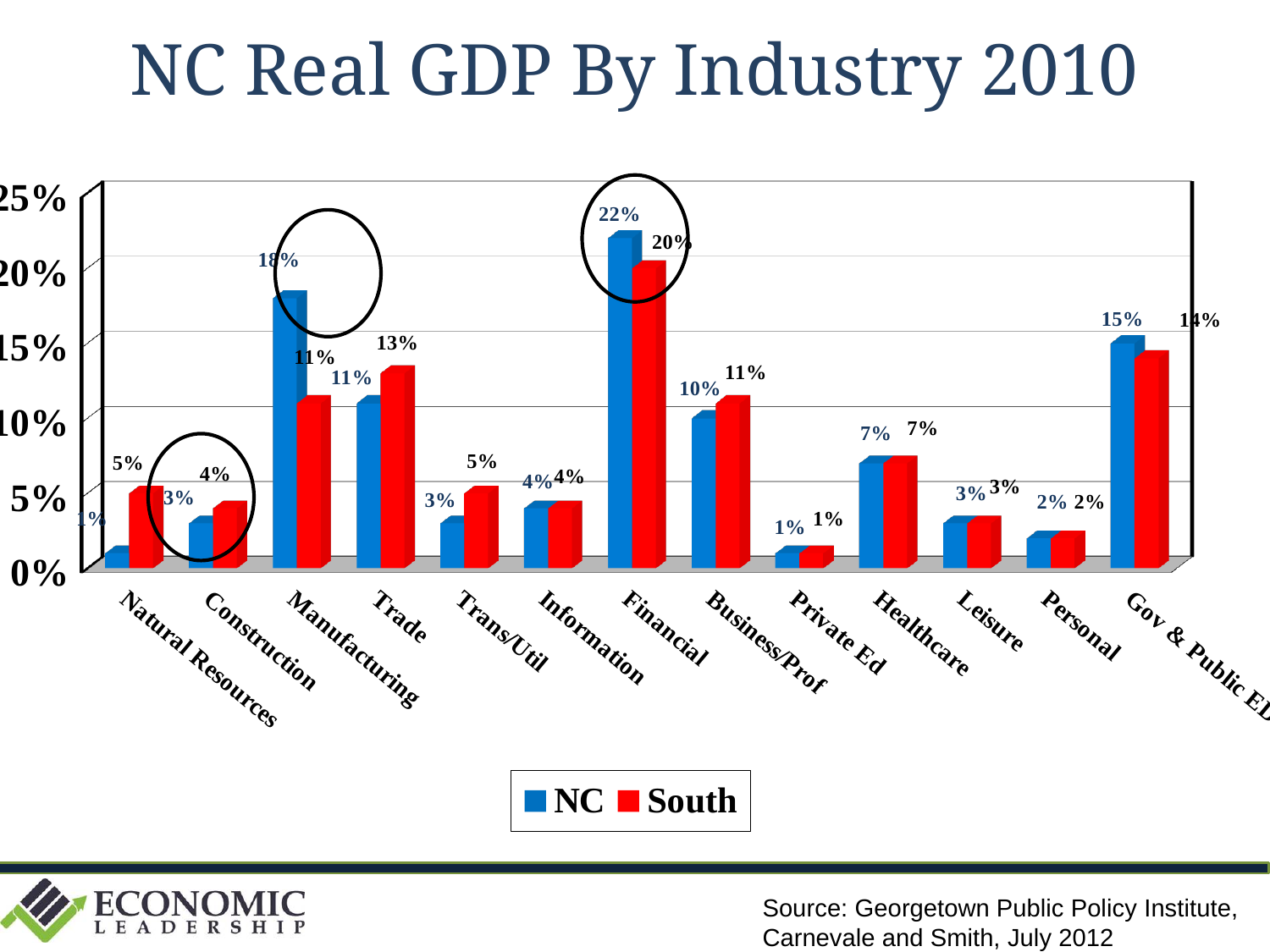
Which industry has the highest South value? Financial What is the difference between the NC and South values for Manufacturing? 7% What is the South value for Trade? 13% What is the difference between the NC and South values for Financial? 2% Which is larger for Natural Resources, the NC value or the South value? South What kind of chart is shown on the slide? Bar chart What is the title of the chart? NC Real GDP By Industry 2010 What is the NC value for Manufacturing? 18% Which industry has the highest NC value? Financial How many series does the legend list? 2 What is the South value for Business/Prof? 11% What is the NC value for Financial? 22%